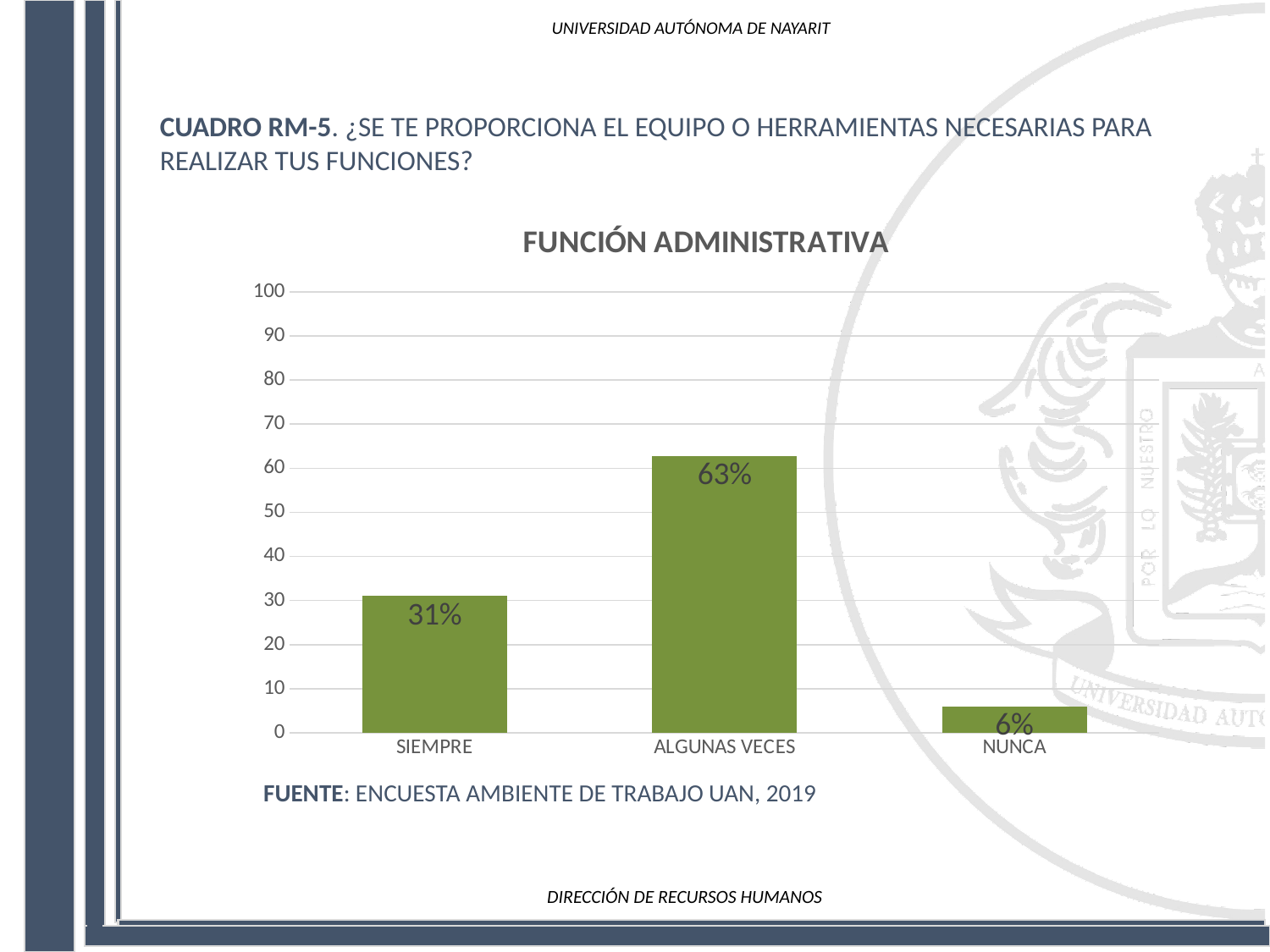
Is the value for ALGUNAS VECES greater or less than 50? greater What is the difference between the values for ALGUNAS VECES and SIEMPRE? 32% What is the title of the chart? FUNCIÓN ADMINISTRATIVA What is the value for SIEMPRE? 31% How many categories are shown on the x axis? 3 What is the value for NUNCA? 6% What is the value for ALGUNAS VECES? 63% Which category has the lowest value? NUNCA Which category has the highest value? ALGUNAS VECES What kind of chart is shown on the slide? bar chart What is the difference between the values for SIEMPRE and NUNCA? 25% Which is larger, the value for SIEMPRE or the value for NUNCA? SIEMPRE